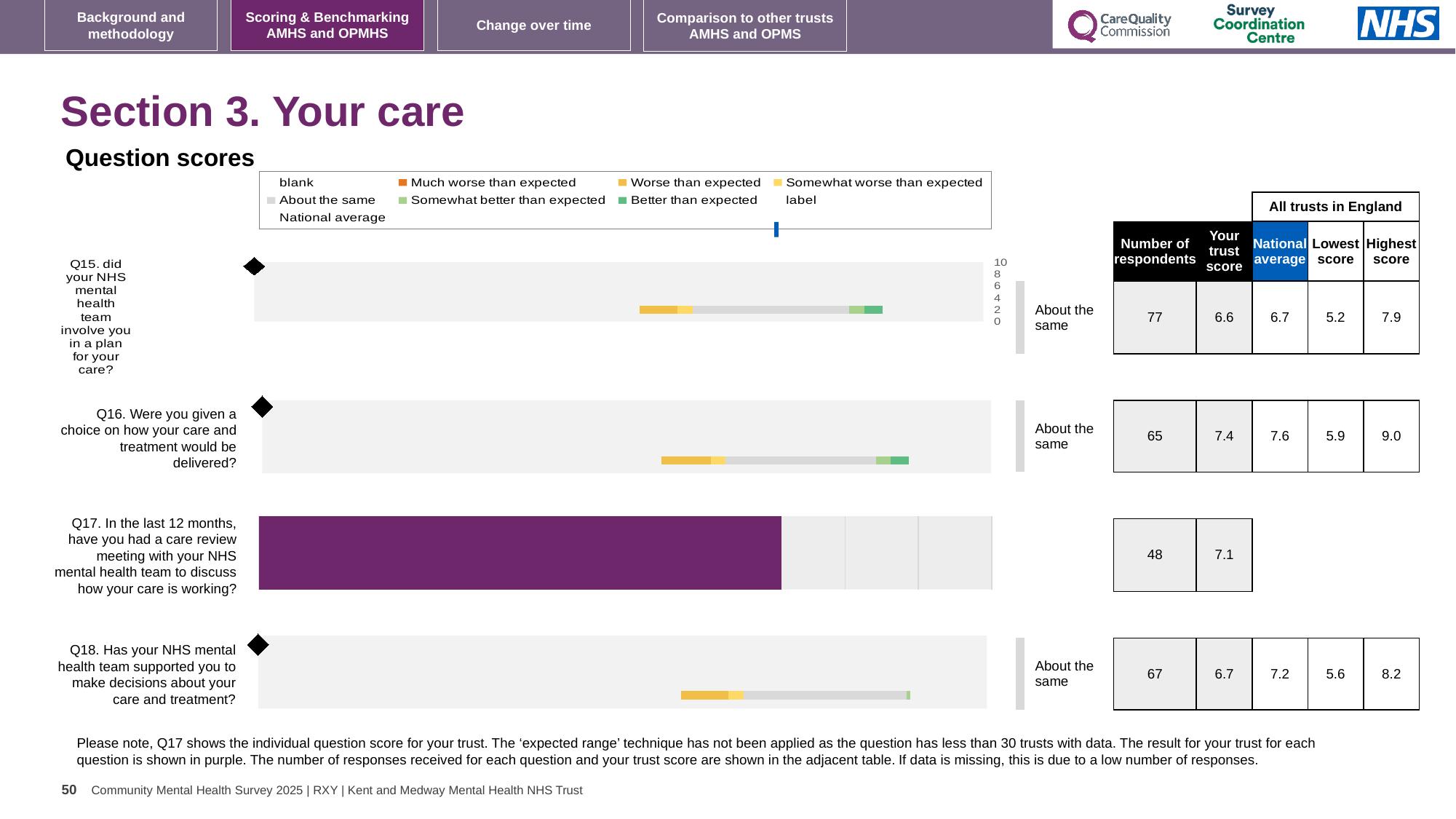
What is the difference between the highest score and the lowest score for Q16? 3.1 How many questions are plotted on this slide? 4 How many respondents answered Q17? 48 Which question has the lowest trust score on this slide? Q15 What colour is the bar for Q17? Purple What is the trust score for Q15 (did your NHS mental health team involve you in a plan for your care)? 6.6 What is the highest score among all trusts in England for Q18? 8.2 What is the national average for Q16 (were you given a choice on how your care and treatment would be delivered)? 7.6 What kind of chart is used to show the question scores? Bar chart What comparison label is shown next to the Q15 chart? About the same For Q18, which is larger: the trust score or the national average? National average Which question has the highest trust score on this slide? Q16